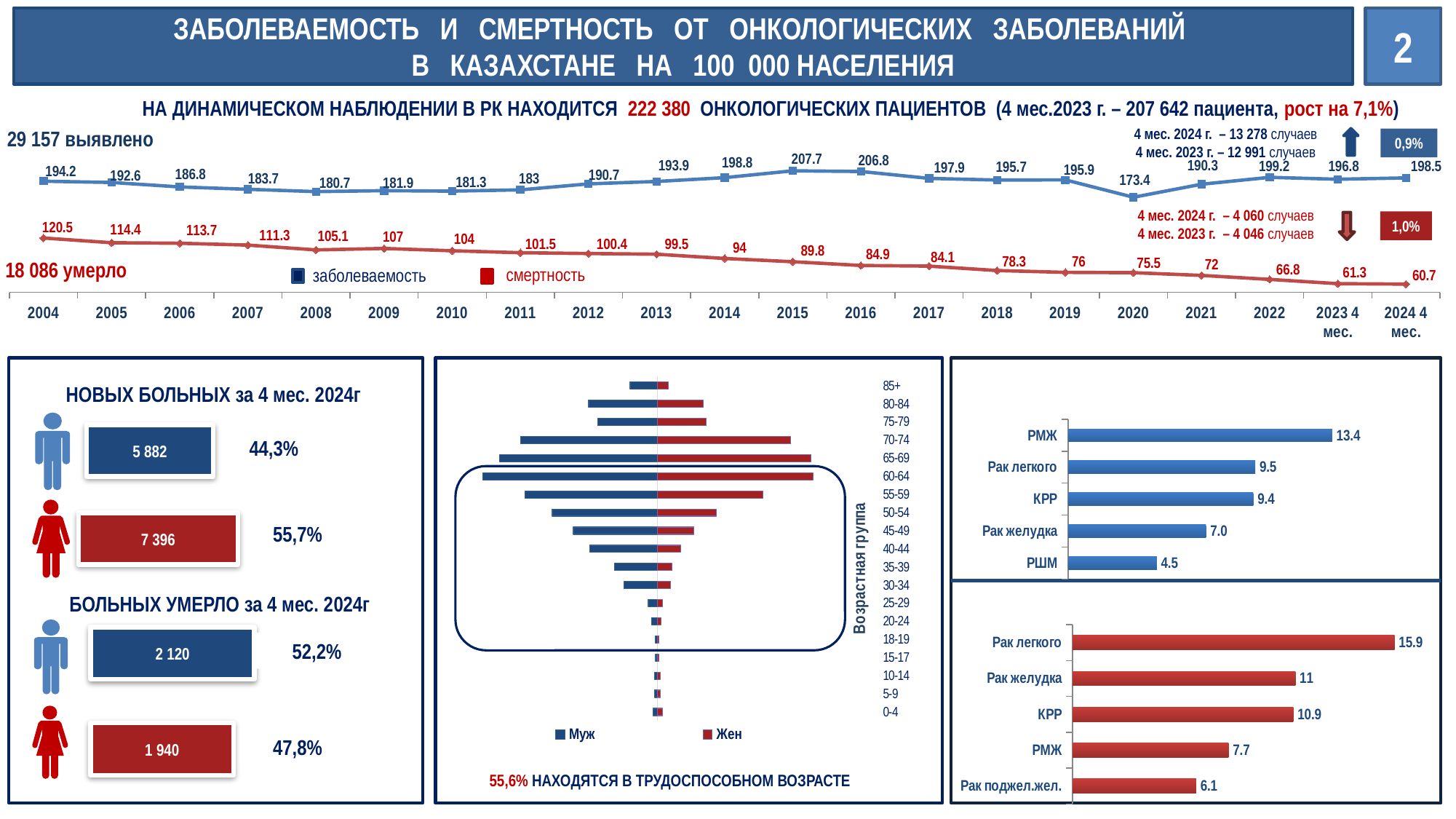
In the top line chart, what is the difference between заболеваемость and смертность in 2013? 94.4 In the top line chart, what is the value of заболеваемость (incidence) in 2015? 207.7 In the red bar chart at the bottom right, which category has the lowest value? Рак поджел.жел. In the top line chart, how many series does the legend list? 2 In the blue bar chart on the right, what is the value for Рак легкого? 9.5 In the top line chart, in which year is the заболеваемость value lowest? 2020 In the top line chart, does the смертность series rise or fall from 2004 to 2024 4 мес.? fall In the blue bar chart on the right, which category has the highest value? РМЖ What type of chart is the middle chart showing age groups (Возрастная группа) by Муж and Жен? bar chart In the top line chart, what is the value of смертность for 2024 4 мес.? 60.7 In the red bar chart at the bottom right, what is the difference between Рак легкого and Рак желудка? 4.9 In the top line chart, what is the value of смертность (mortality) in 2004? 120.5